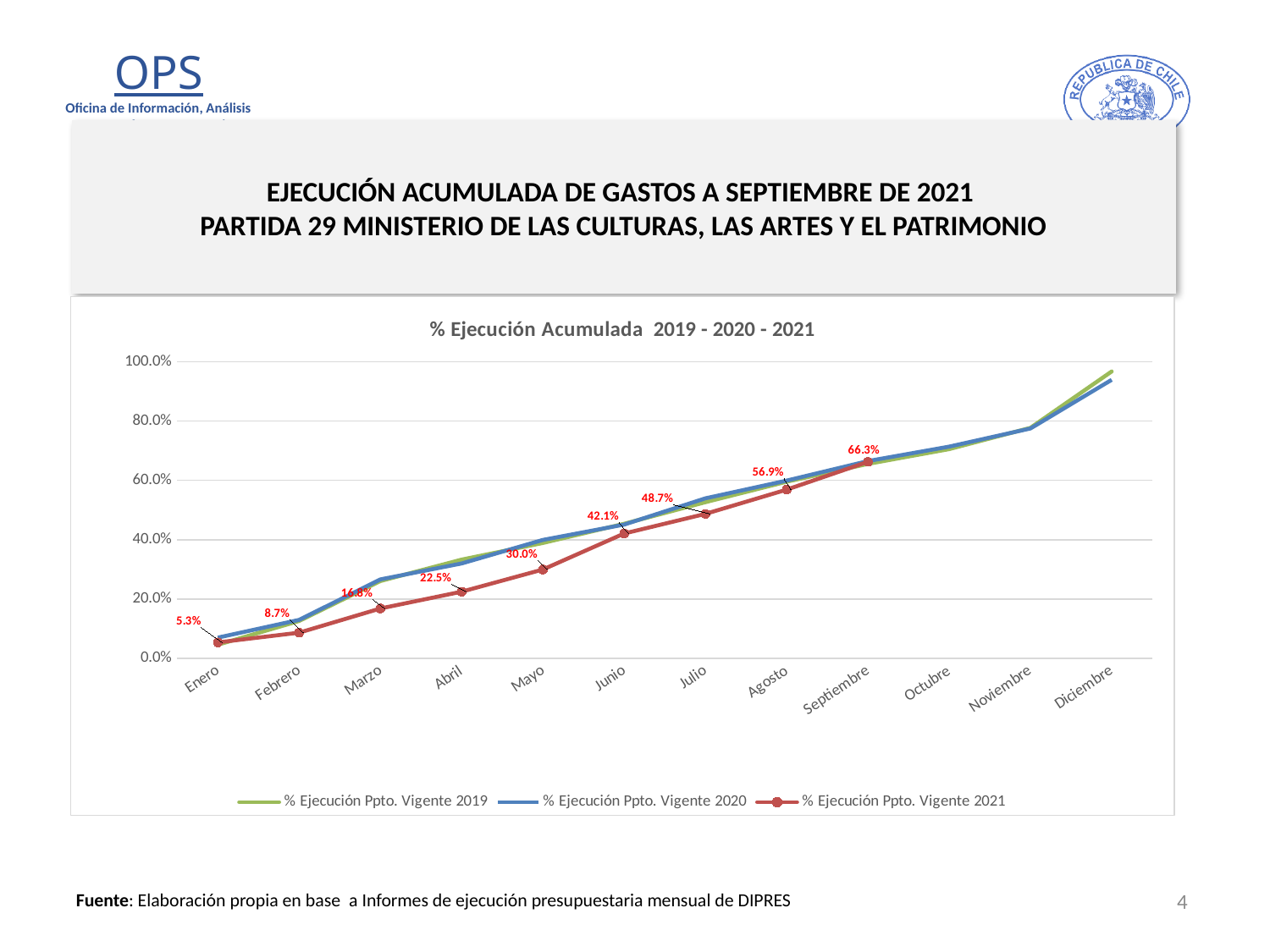
What is the chart's title? % Ejecución Acumulada 2019 - 2020 - 2021 What is the value for % Ejecución Ppto. Vigente 2021 in Septiembre? 66.3% What type of chart is shown on the slide? line chart Is the value for % Ejecución Ppto. Vigente 2020 in Noviembre greater or less than 60.0%? greater Does the % Ejecución Ppto. Vigente 2021 series rise or fall from Enero to Septiembre? rise What is the difference between the 2021 values for Junio and Mayo? 12.1% Which is larger in Marzo: the 2020 value or the 2021 value? 2020 What is the value for % Ejecución Ppto. Vigente 2021 in Mayo? 30.0% What is the value for % Ejecución Ppto. Vigente 2021 in Enero? 5.3% What is the difference between the 2021 values for Septiembre and Agosto? 9.4% How many months are shown on the x axis? 12 How many series does the legend list? 3